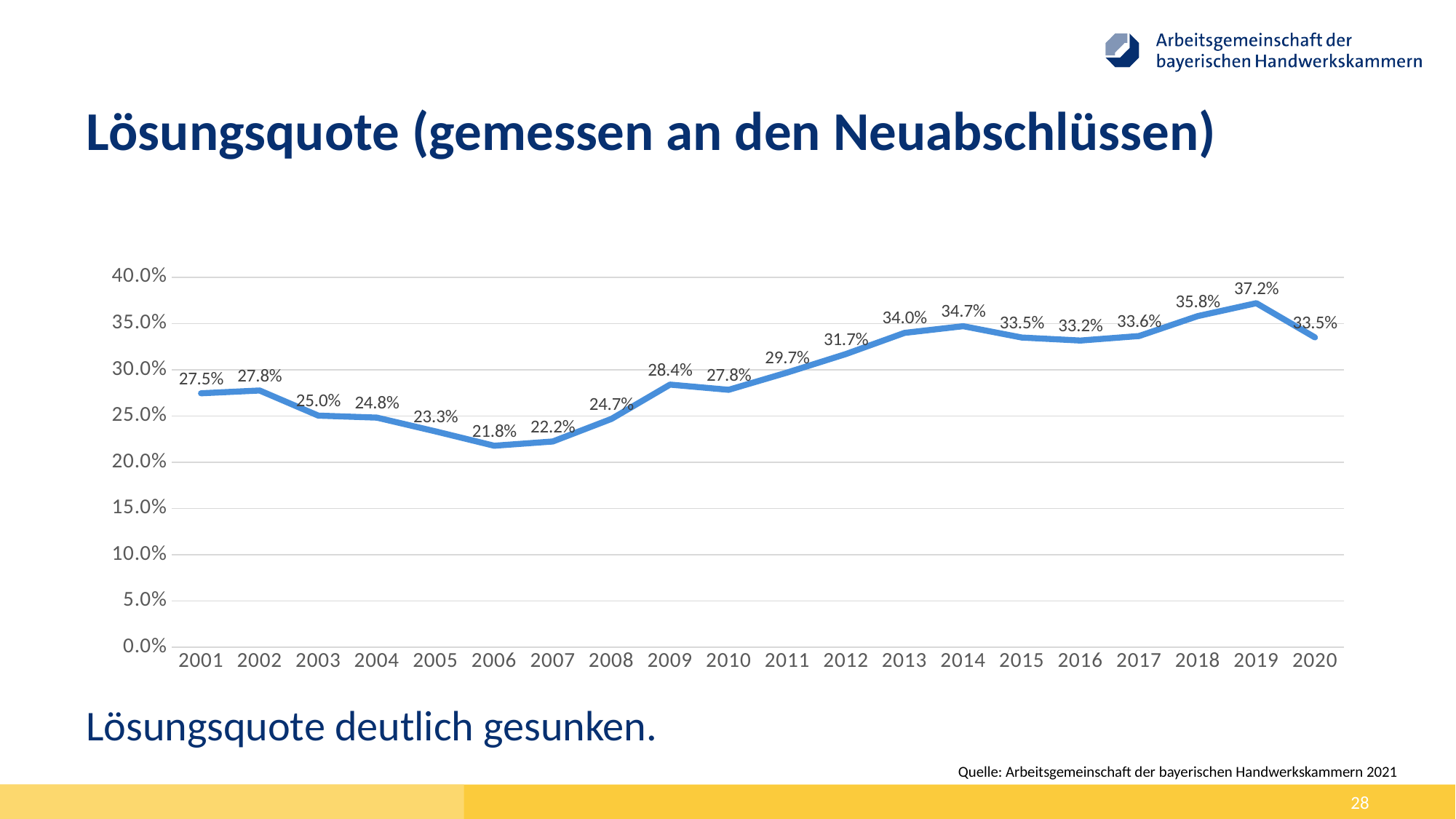
How many years are shown on the x axis? 20 What is the difference between the Lösungsquote in 2019 and 2020? 3.7% What is the Lösungsquote for 2020? 33.5% What is the title of the slide? Lösungsquote (gemessen an den Neuabschlüssen) Which year has the highest Lösungsquote? 2019 Which year has a higher Lösungsquote, 2009 or 2010? 2009 What is the Lösungsquote for 2006? 21.8% Which year has the lowest Lösungsquote? 2006 Is the Lösungsquote for 2012 greater or less than 30.0%? greater What is the Lösungsquote for 2019? 37.2% What kind of chart is shown on the slide? line chart Does the Lösungsquote rise or fall from 2006 to 2014? rise